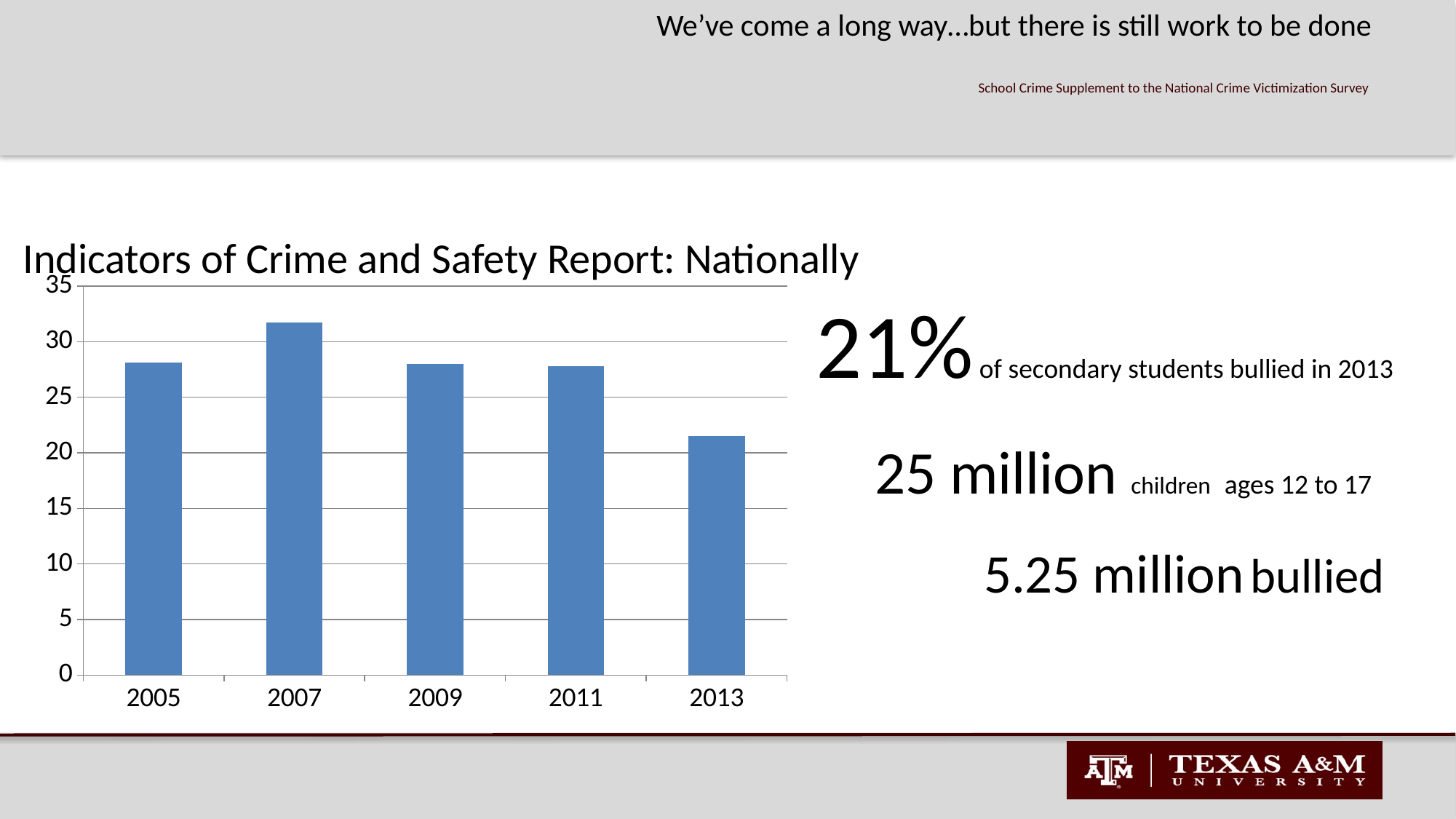
Which year has the lowest bar in the chart? 2013 Is the value for 2005 greater or less than 25? greater Is the value for 2011 greater or less than 30? less Which year has the highest bar in the chart? 2007 From 2007 to 2013, do the values in the chart rise or fall? fall Is the value for 2007 greater or less than 30? greater What kind of chart is shown on the slide? bar chart Which is larger, the value for 2011 or the value for 2013? 2011 What is the title of the chart? Indicators of Crime and Safety Report: Nationally How many years are shown on the x axis of the chart? 5 Which is larger, the value for 2007 or the value for 2013? 2007